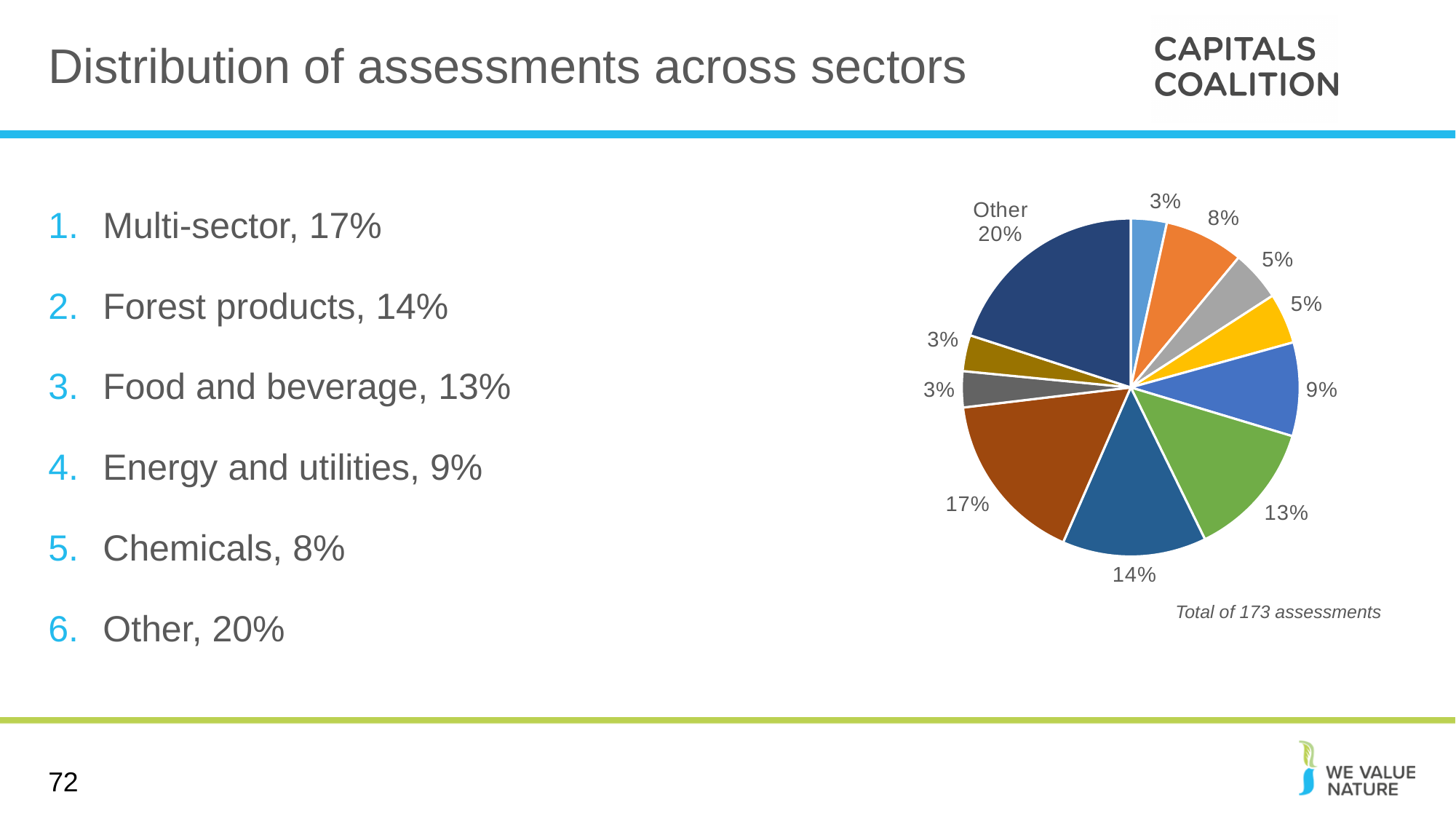
Which slice of the pie chart is the largest? Other, 20% What is the title of the slide containing the pie chart? Distribution of assessments across sectors How many slices of the pie chart are labelled 3%? 3 According to the slide, which has the larger share of assessments: Forest products or Food and beverage? Forest products What is the difference in percentage points between the 'Other' slice (20%) and the 17% slice? 3 What kind of chart is shown on the slide? pie chart How many slices does the pie chart have? 11 What share of assessments does the slide give for Chemicals? 8% What percentage does the 'Other' slice of the pie chart represent? 20% How many slices of the pie chart are labelled 5%? 2 What is the smallest percentage labelled on any slice of the pie chart? 3% According to the note under the pie chart, how many assessments are included in total? 173